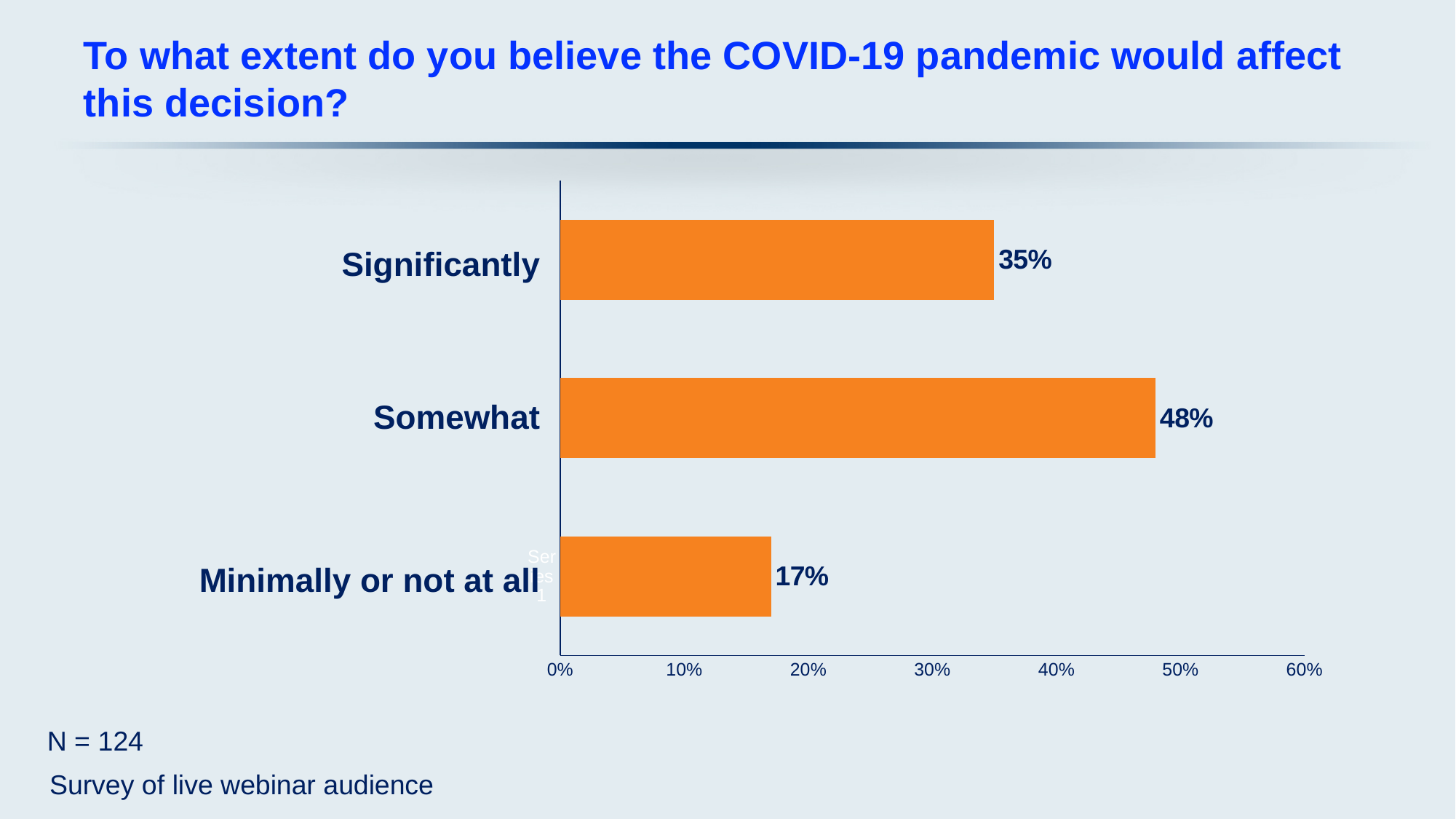
What percentage of respondents answered "Somewhat"? 48% What is the difference in percentage points between "Somewhat" and "Significantly"? 13 Which is larger, the value for "Significantly" or the value for "Minimally or not at all"? Significantly What percentage of respondents answered "Significantly"? 35% Is the value for "Somewhat" greater or less than 40%? greater Which response category has the lowest percentage? Minimally or not at all How many response categories are shown in the chart? 3 What is the sample size (N) stated on the slide? 124 What kind of chart is shown on the slide? Bar chart Which response category has the highest percentage? Somewhat What percentage of respondents answered "Minimally or not at all"? 17% What is the difference in percentage points between "Significantly" and "Minimally or not at all"? 18